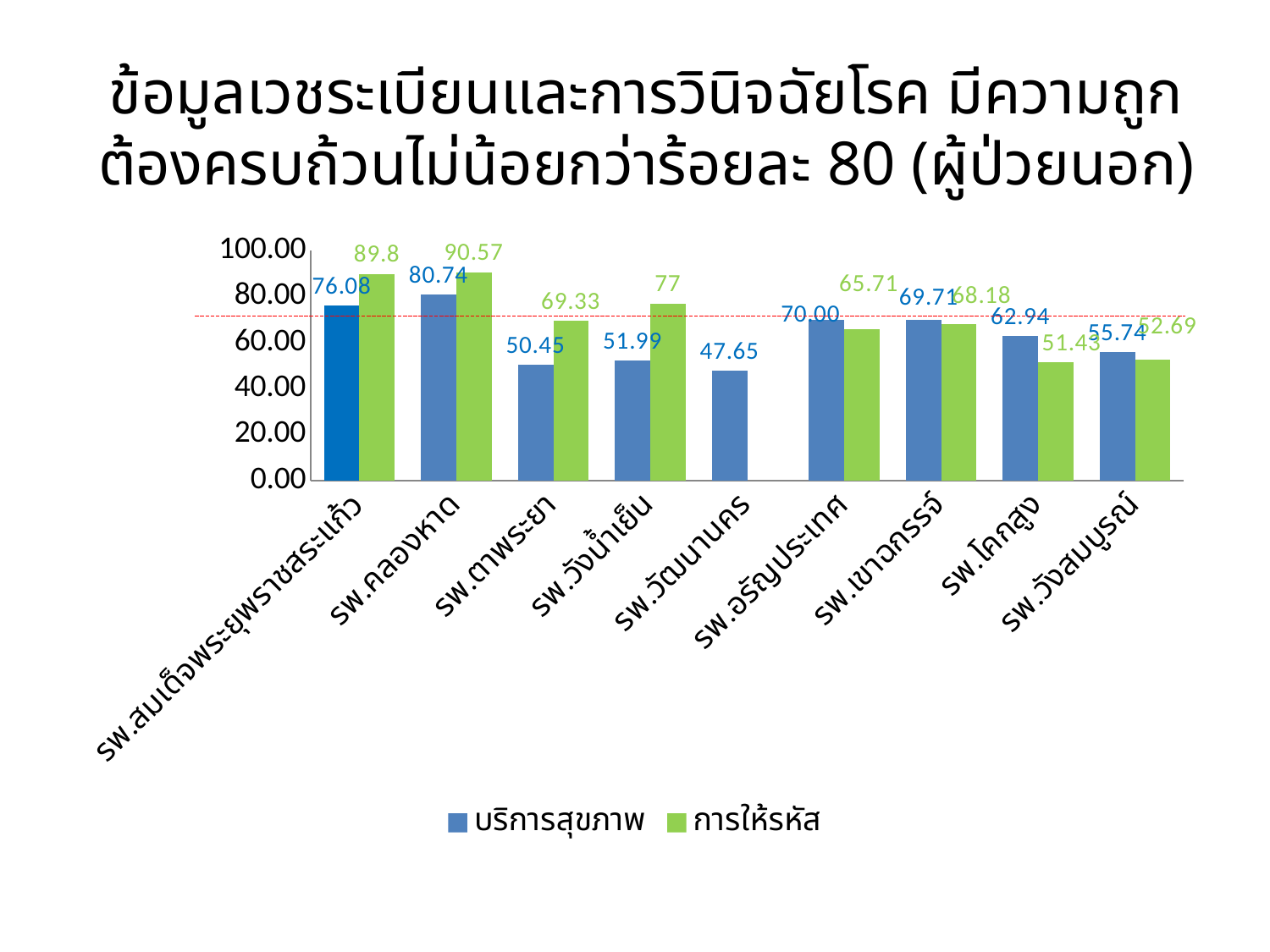
What is the difference between the การให้รหัส and บริการสุขภาพ values for รพ.ตาพระยา? 18.88 What is the บริการสุขภาพ value for รพ.คลองหาด? 80.74 What is the การให้รหัส value for รพ.วังน้ำเย็น? 77 What kind of chart is shown on the slide? bar chart Which series is shown in green in the legend? การให้รหัส Is the บริการสุขภาพ value for รพ.สมเด็จพระยุพราชสระแก้ว greater or less than 80? less How many hospitals are shown on the x axis? 9 For รพ.โคกสูง, which is larger: the บริการสุขภาพ value or the การให้รหัส value? บริการสุขภาพ What is the บริการสุขภาพ value for รพ.วัฒนานคร? 47.65 Which hospital has the highest การให้รหัส value? รพ.คลองหาด How many series does the legend list? 2 Which hospital has the lowest บริการสุขภาพ value? รพ.วัฒนานคร